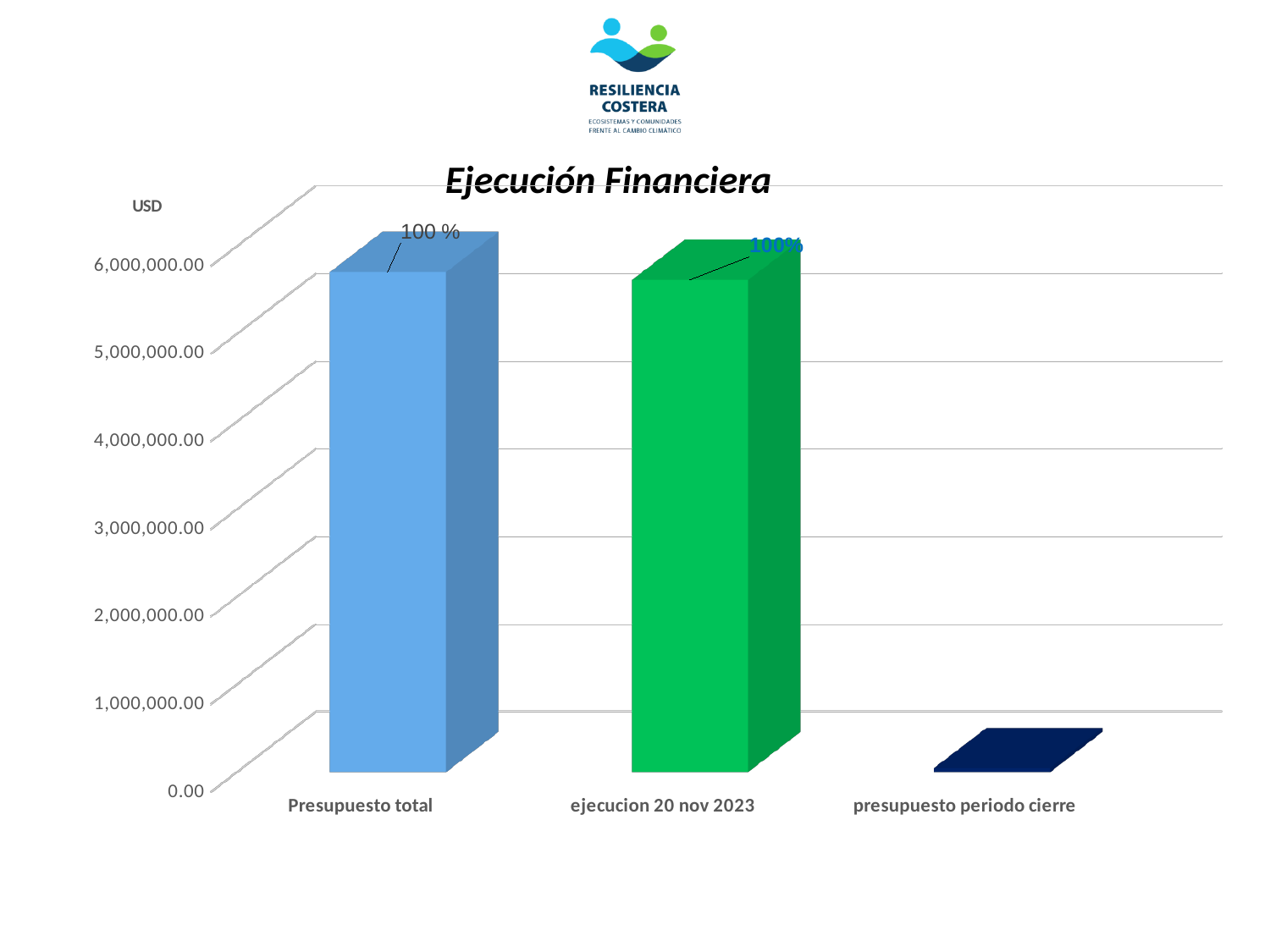
Is the value for ejecucion 20 nov 2023 greater or less than 4,000,000.00? greater What unit is indicated at the top of the vertical axis? USD What is the highest tick value shown on the vertical axis? 6,000,000.00 Is the value for Presupuesto total greater or less than 5,000,000.00? greater What percentage label is shown on the ejecucion 20 nov 2023 bar? 100% Which category has the lowest value in the chart? presupuesto periodo cierre What kind of chart is shown on the slide? bar chart How many categories are shown on the x axis of the chart? 3 Which is larger, the value for Presupuesto total or the value for presupuesto periodo cierre? Presupuesto total Which is larger, the value for ejecucion 20 nov 2023 or the value for presupuesto periodo cierre? ejecucion 20 nov 2023 Is the value for presupuesto periodo cierre greater or less than 1,000,000.00? less What is the title of the chart? Ejecución Financiera